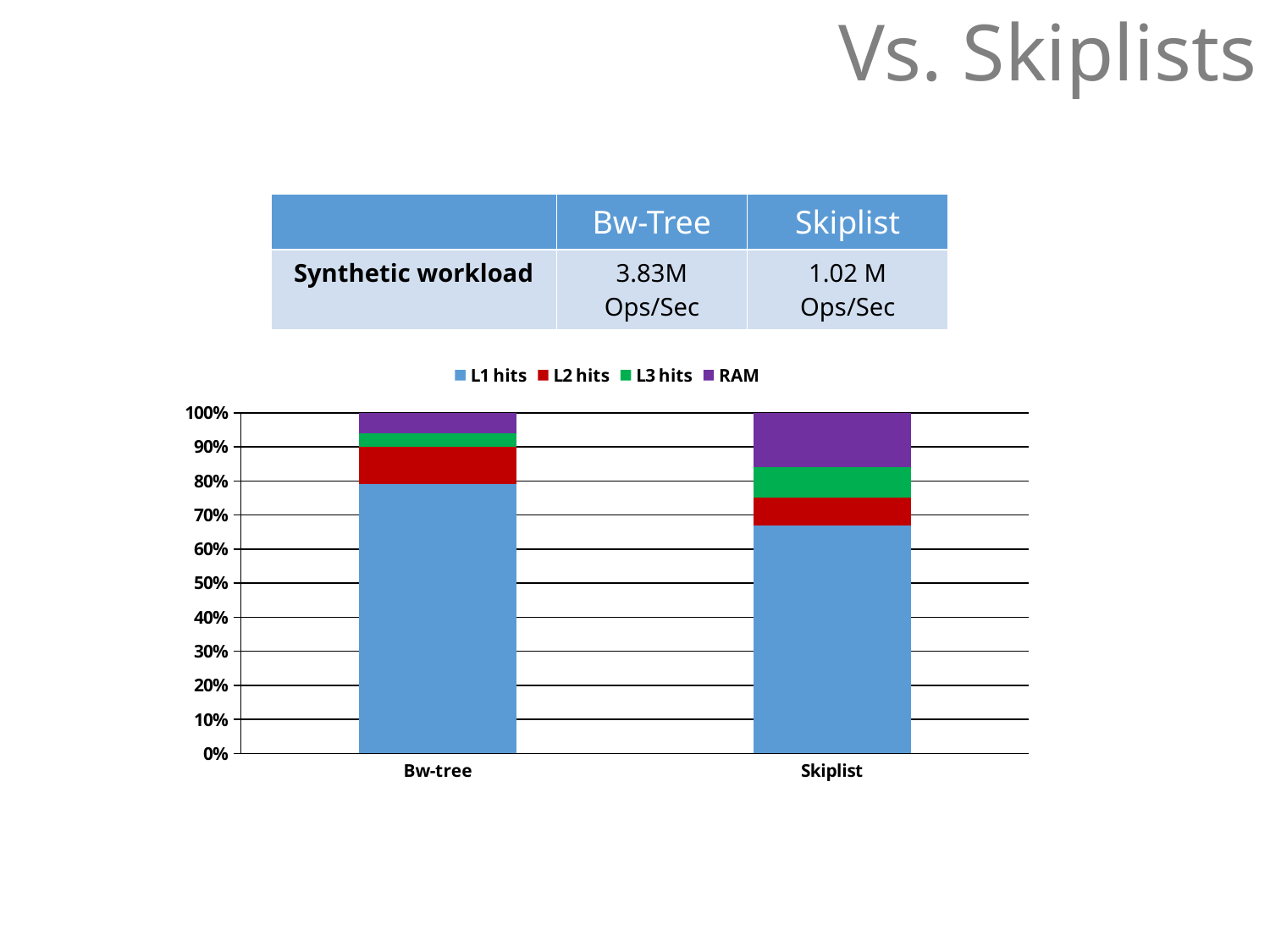
Which category has the larger RAM share, Bw-tree or Skiplist? Skiplist Is the L1 hits share for Bw-tree greater or less than 70%? greater How many series does the chart legend list? 4 Which category has the larger L3 hits share, Bw-tree or Skiplist? Skiplist Which colour represents RAM in the chart? Purple What is the total height of the stacked bar for Bw-tree? 100% Is the L1 hits share for Skiplist greater or less than 60%? greater What are the series listed in the chart legend? L1 hits, L2 hits, L3 hits, RAM What kind of chart is shown on the slide? Stacked bar chart Is the L1 hits share for Skiplist greater or less than 80%? less Which category has the larger L1 hits share, Bw-tree or Skiplist? Bw-tree How many categories are shown on the x axis of the chart? 2